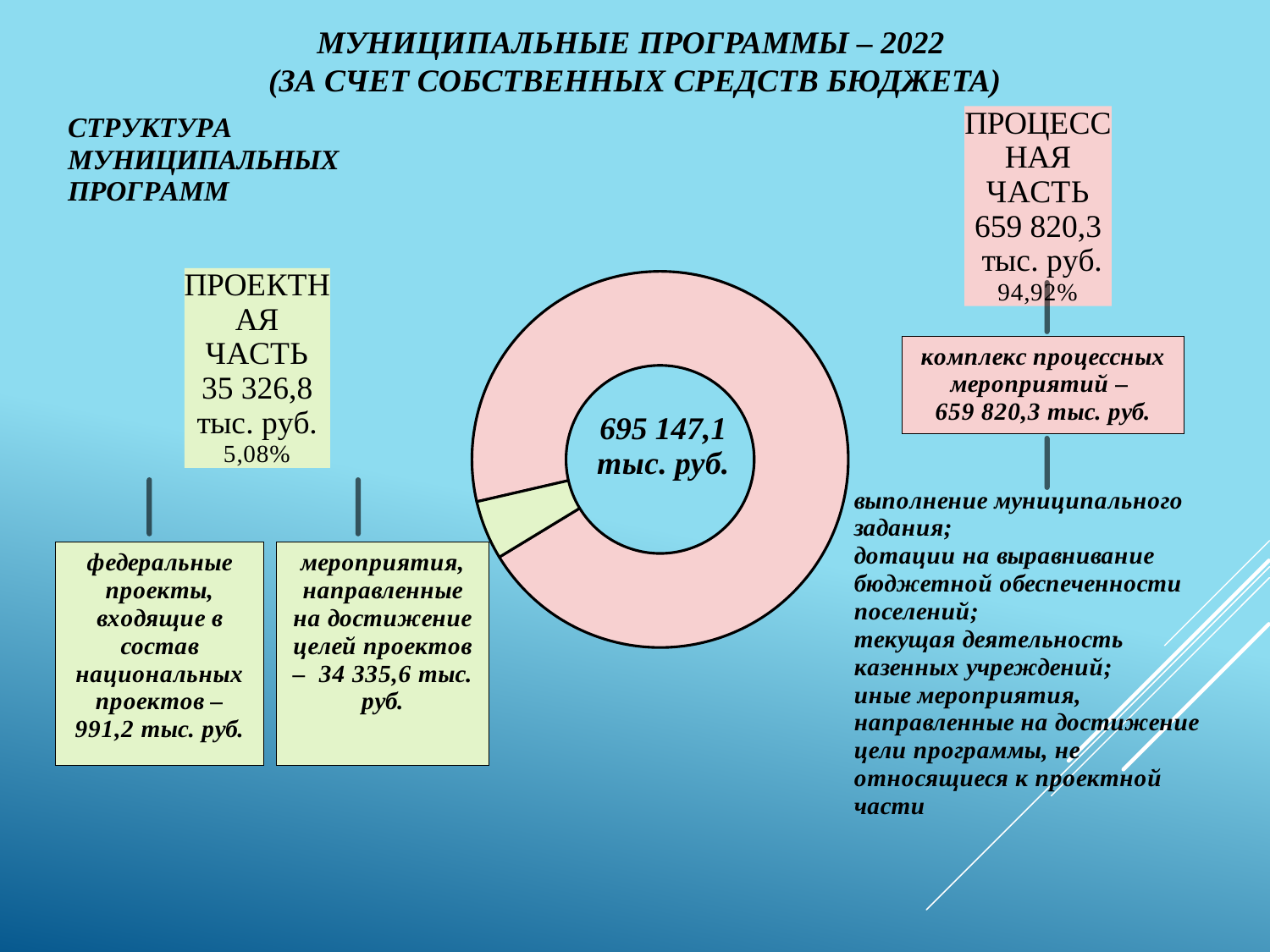
How many slices does the donut chart have? 2 What share of the donut chart does the проектная часть represent? 5,08% What is the difference between the процессная часть and the проектная часть values? 624 493,5 тыс. руб. What kind of chart is shown in the centre of the slide? Donut (pie) chart Which part has the smallest slice in the donut chart? Проектная часть What is the total value shown in the centre of the donut chart? 695 147,1 тыс. руб. What is the value of the федеральные проекты (federal projects) within the проектная часть? 991,2 тыс. руб. What is the value of the проектная часть (project part) shown on the slide? 35 326,8 тыс. руб. What is the value of the процессная часть (process part) shown on the slide? 659 820,3 тыс. руб. Which part is larger in the donut chart, the процессная часть or the проектная часть? Процессная часть What share of the donut chart does the процессная часть represent? 94,92% What colour is the slice representing the процессная часть in the donut chart? Pink